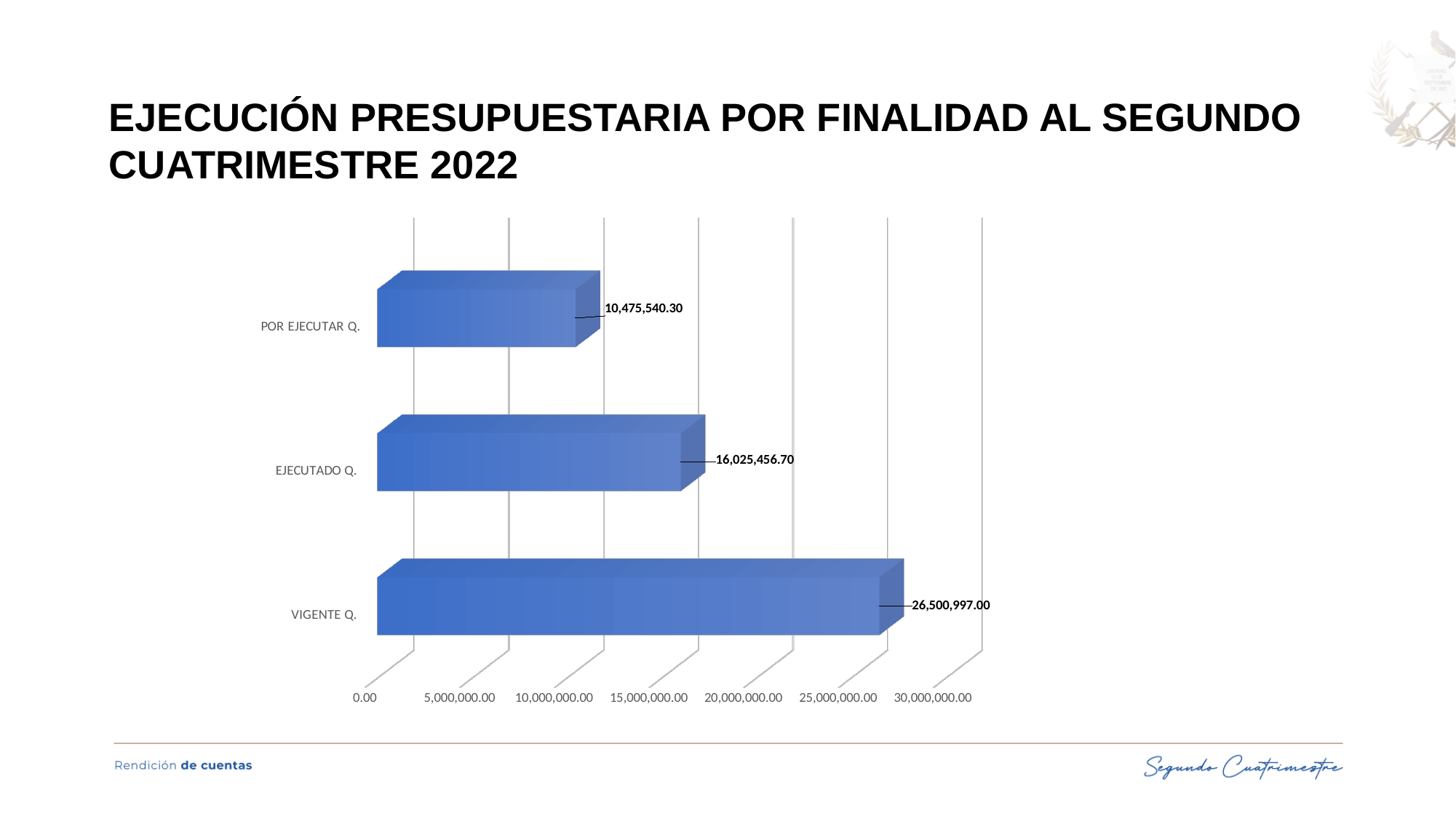
What is the difference between the values for VIGENTE Q. and EJECUTADO Q.? 10,475,540.30 What is the title of the slide containing the chart? EJECUCIÓN PRESUPUESTARIA POR FINALIDAD AL SEGUNDO CUATRIMESTRE 2022 Which category has the lowest value? POR EJECUTAR Q. What kind of chart is shown on the slide? bar chart What is the value for EJECUTADO Q.? 16,025,456.70 What is the difference between the values for EJECUTADO Q. and POR EJECUTAR Q.? 5,549,916.40 How many categories are shown in the chart? 3 Is the value for VIGENTE Q. greater or less than 25,000,000.00? greater What is the value for VIGENTE Q.? 26,500,997.00 Which is larger, the value for EJECUTADO Q. or the value for POR EJECUTAR Q.? EJECUTADO Q. What is the value for POR EJECUTAR Q.? 10,475,540.30 Which category has the highest value? VIGENTE Q.